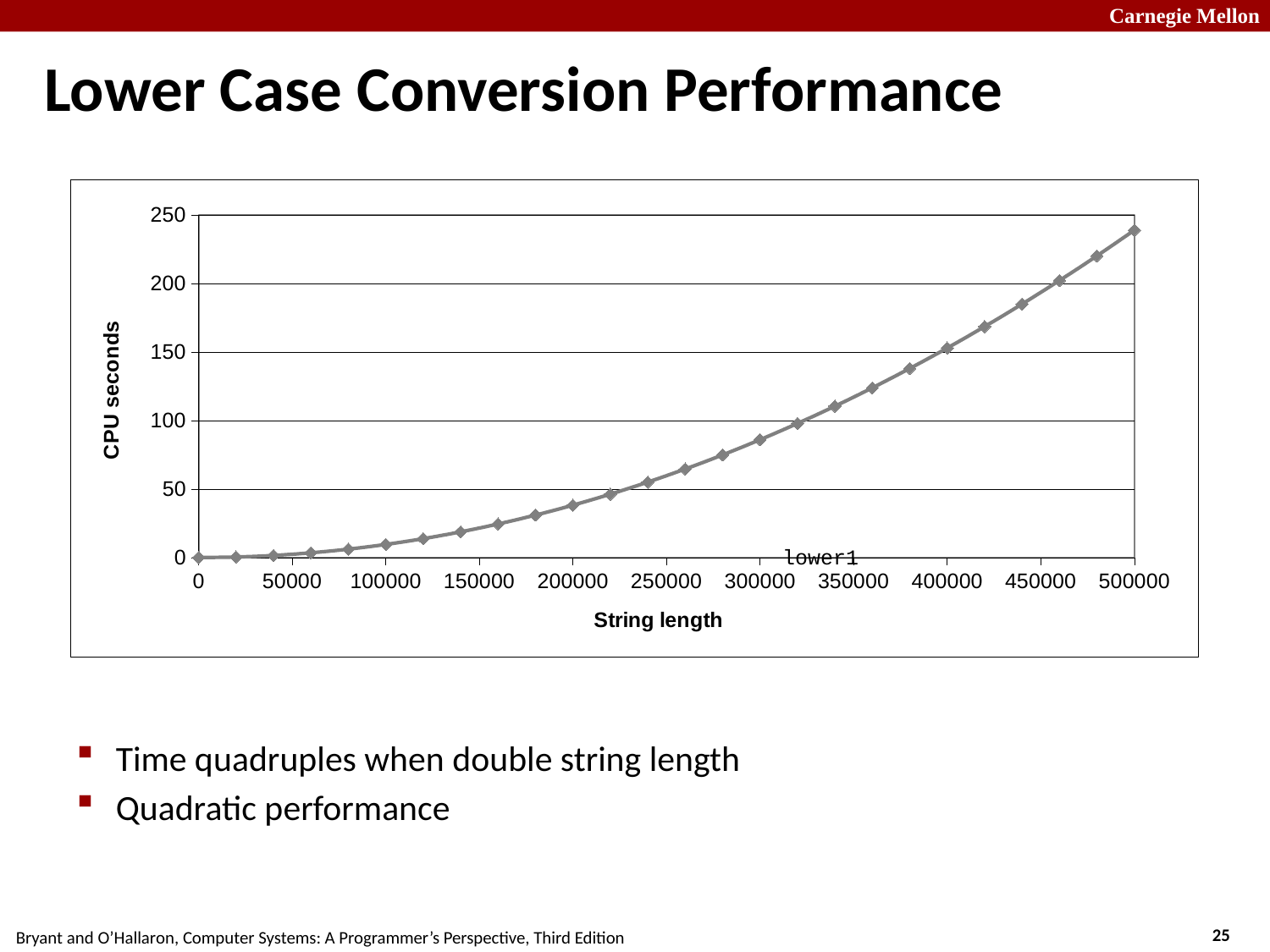
At which string length is the CPU time lowest? 0 Which has the larger CPU time, string length 400000 or string length 200000? 400000 Do the CPU seconds rise or fall as string length increases? rise What is the label of the y axis? CPU seconds How many data points are plotted on the line? 26 Is the CPU time at string length 300000 greater or less than 100? less Is the CPU time at string length 200000 greater or less than 50? less What kind of chart is shown on the slide? line chart Is the CPU time at string length 500000 greater or less than 200? greater At which string length is the CPU time highest? 500000